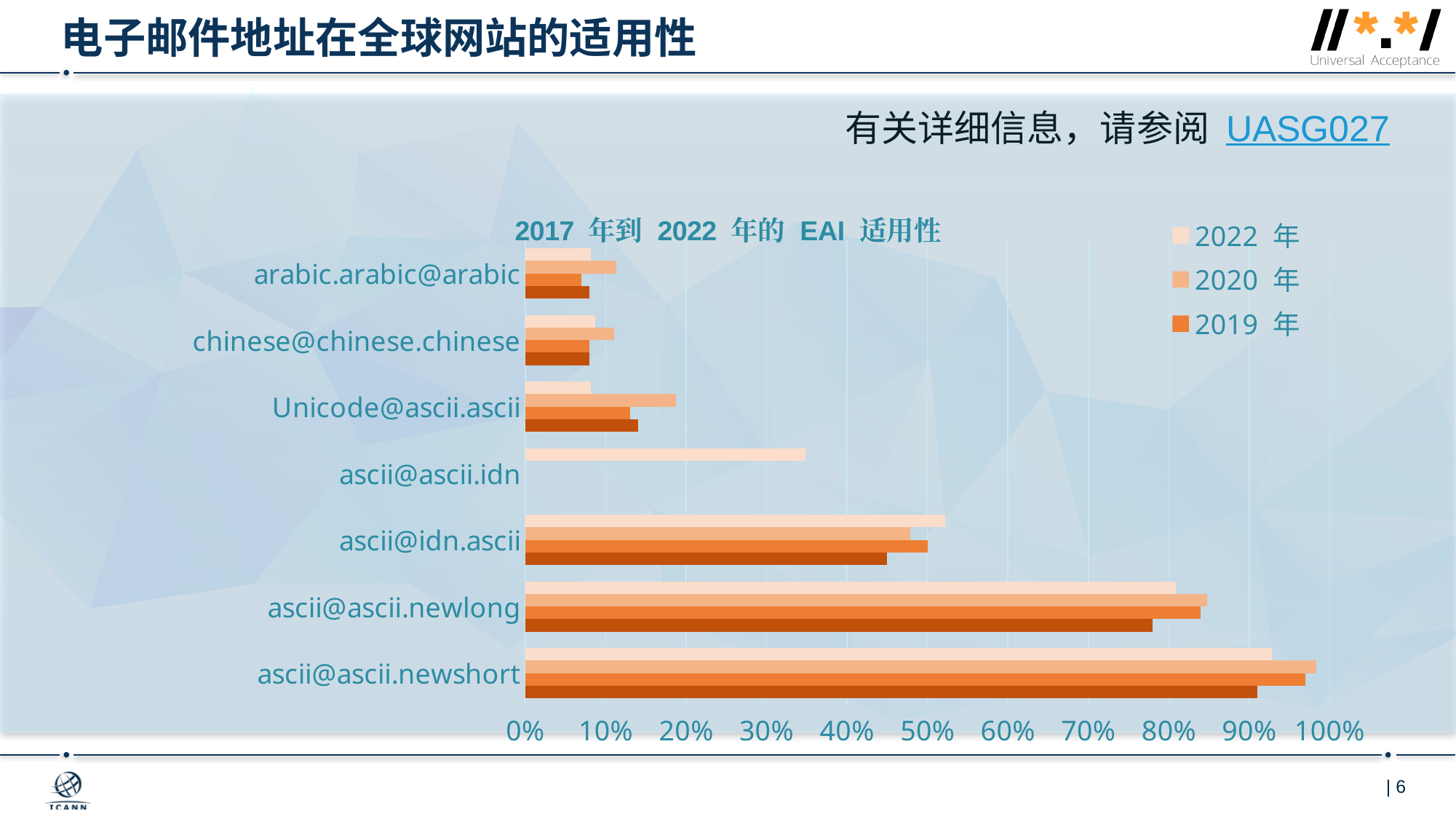
How many series does the legend list? 3 Is the 2022 年 value for ascii@ascii.idn greater or less than 30%? greater How many email address categories are plotted on the chart? 7 What kind of chart is shown on the slide? bar chart Is the 2020 年 value for Unicode@ascii.ascii greater or less than 10%? greater What is the title of the chart? 2017 年到 2022 年的 EAI 适用性 Is the 2019 年 value for ascii@ascii.newshort greater or less than 80%? greater Which category has the highest value for the 2019 年 series? ascii@ascii.newshort Which category has the highest value for the 2022 年 series? ascii@ascii.newshort For ascii@idn.ascii, which series has the larger value, 2022 年 or 2019 年? 2022 年